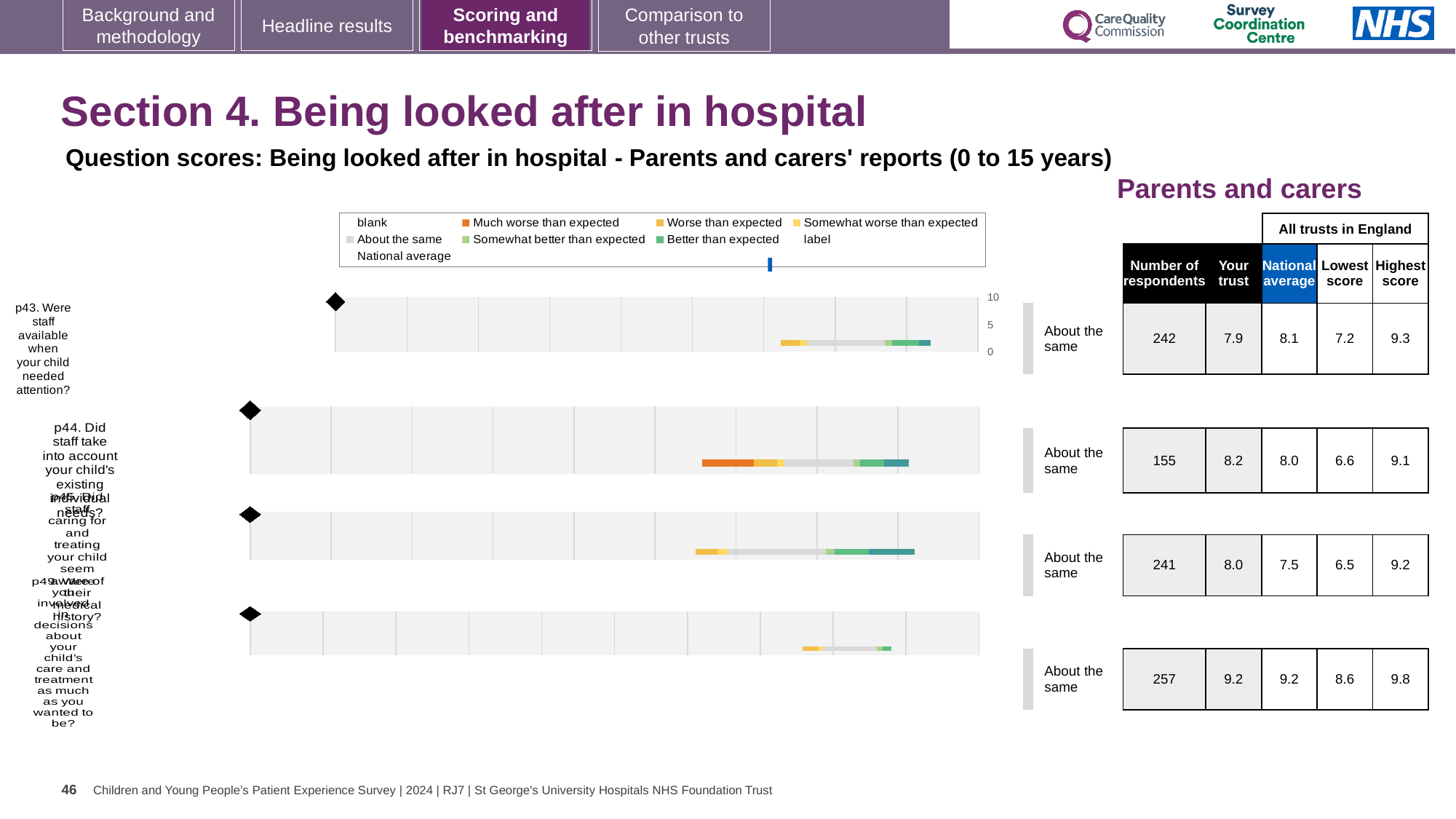
Which question chart has the lowest number of respondents? p44 For the p45 chart, what is the difference between the 'Your trust' score (8.0) and the national average (7.5)? 0.5 How many entries does the chart legend list? 9 How many question bar charts are shown on the slide? 4 For the p45 chart, what is the lowest score among all trusts in England? 6.5 For the p43 chart (Were staff available when your child needed attention?), what is the number of respondents? 242 Which question chart has the highest 'Your trust' score? p49 What kind of chart is used to show the question scores on this slide? bar chart For the p49 chart, what is the highest score among all trusts in England? 9.8 What benchmark category is shown next to the p43 chart? About the same For the p44 chart, which is larger: the 'Your trust' score or the national average? Your trust For the p44 chart (Did staff take into account your child's existing individual needs?), what is the 'Your trust' score? 8.2